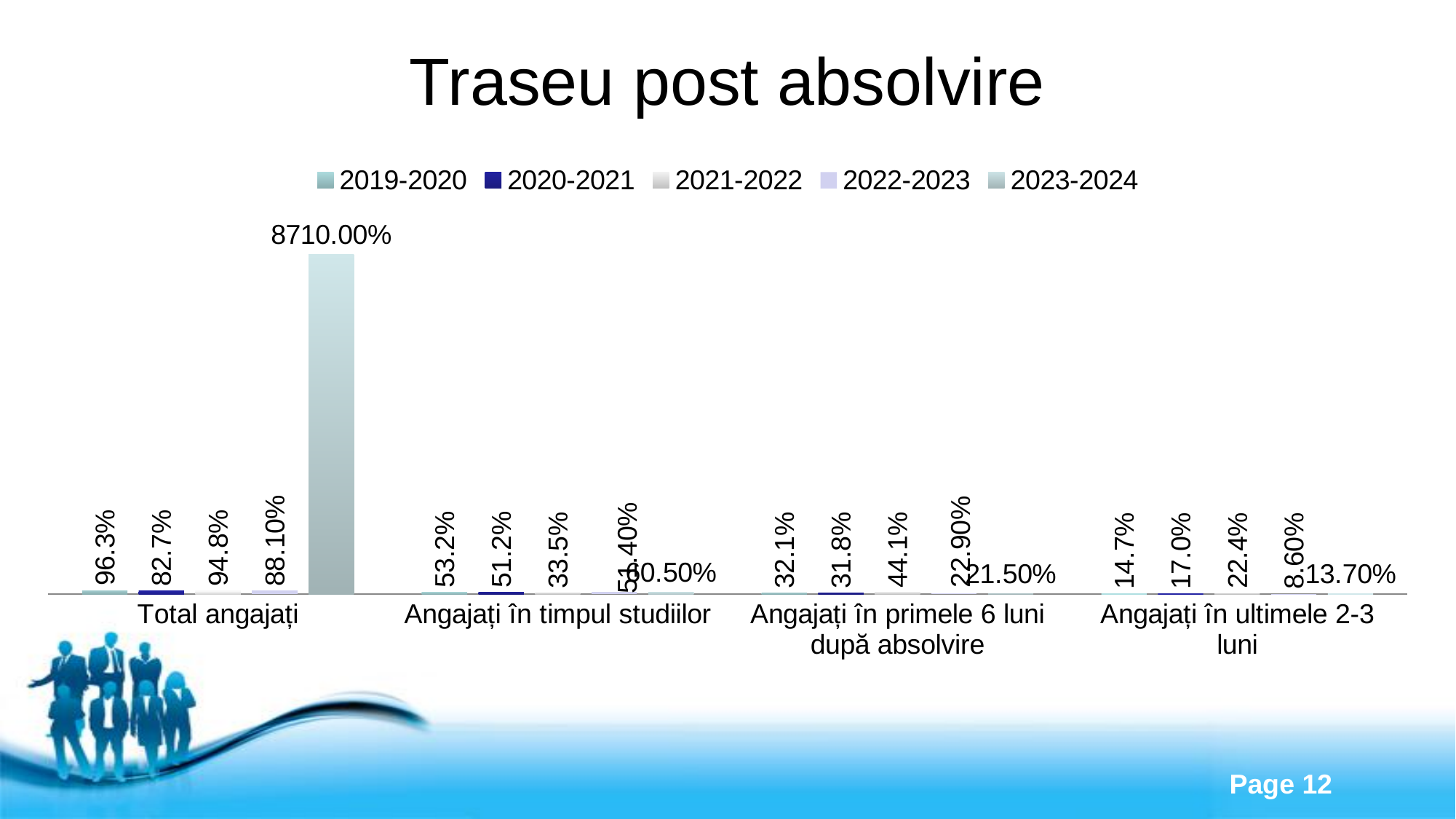
Which series has the lowest value in the 'Angajați în ultimele 2-3 luni' category? 2022-2023 How many categories are shown on the x axis? 4 What is the value for 2022-2023 in the 'Angajați în ultimele 2-3 luni' category? 8.60% What is the value for 2021-2022 in the 'Angajați în primele 6 luni după absolvire' category? 44.1% What is the difference between the 2019-2020 and 2020-2021 values in the 'Total angajați' category? 13.6% What is the value for 2023-2024 in the 'Angajați în timpul studiilor' category? 60.50% How many series does the legend list? 5 Which is larger in the 'Angajați în timpul studiilor' category: the 2019-2020 value or the 2021-2022 value? 2019-2020 What kind of chart is shown on the slide? bar chart What is the value for 2019-2020 in the 'Total angajați' category? 96.3% Which series has the highest value in the 'Angajați în primele 6 luni după absolvire' category? 2021-2022 What is the value for 2023-2024 in the 'Total angajați' category? 8710.00%